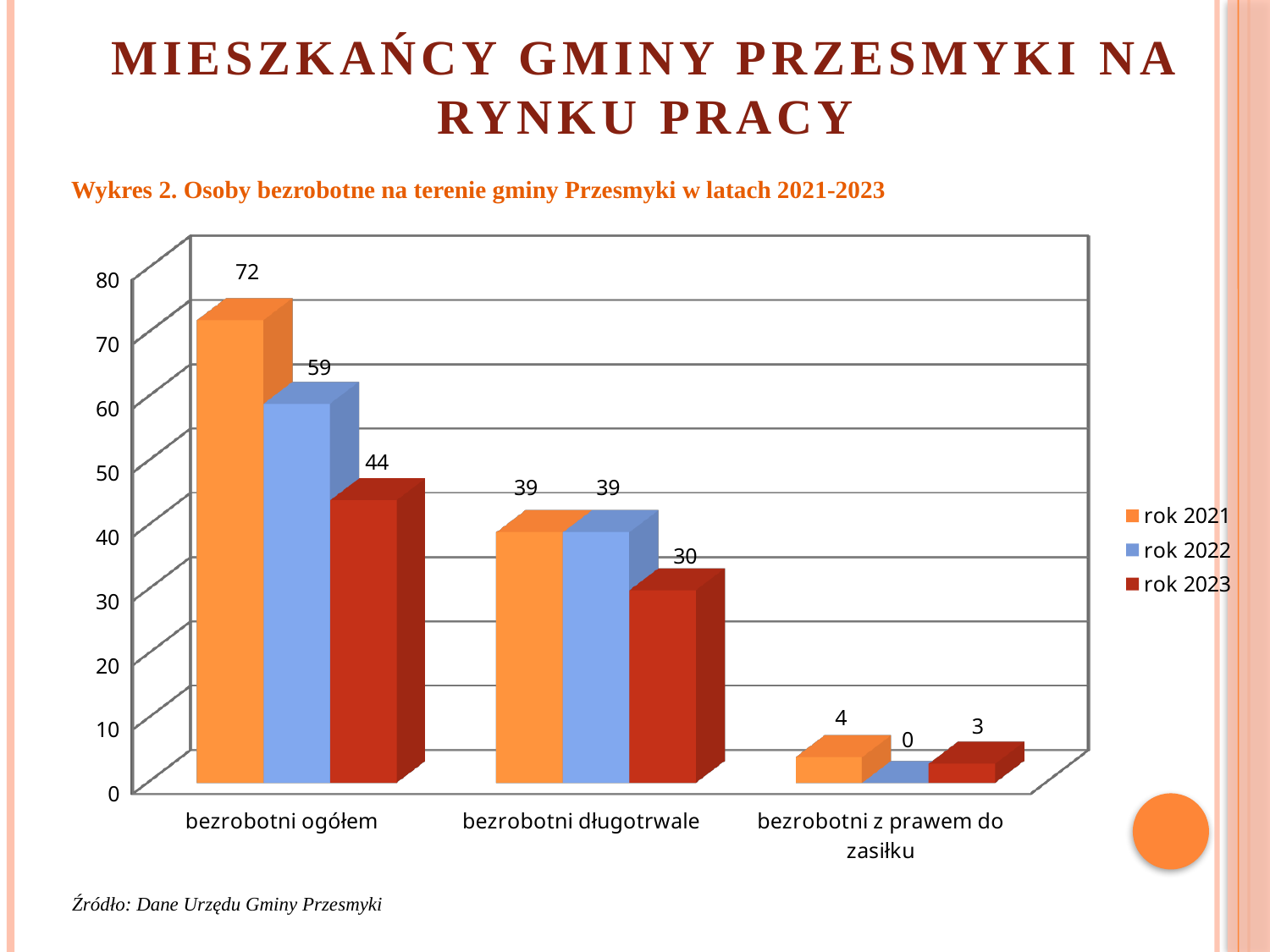
What kind of chart is shown on the slide? bar chart Do the values for 'bezrobotni ogółem' rise or fall from 'rok 2021' to 'rok 2023'? fall What is the value for 'bezrobotni z prawem do zasiłku' in the 'rok 2022' series? 0 Which category has the highest value in the 'rok 2023' series? bezrobotni ogółem What is the title of the chart? Wykres 2. Osoby bezrobotne na terenie gminy Przesmyki w latach 2021-2023 What is the difference between the 'rok 2021' and 'rok 2023' values for 'bezrobotni ogółem'? 28 What is the value for 'bezrobotni ogółem' in the 'rok 2021' series? 72 Which category has the lowest value in the 'rok 2021' series? bezrobotni z prawem do zasiłku How many series does the legend list? 3 What is the value for 'bezrobotni długotrwale' in the 'rok 2023' series? 30 Which is larger for 'bezrobotni ogółem': the 'rok 2022' value or the 'rok 2023' value? rok 2022 How many categories are shown on the x axis? 3